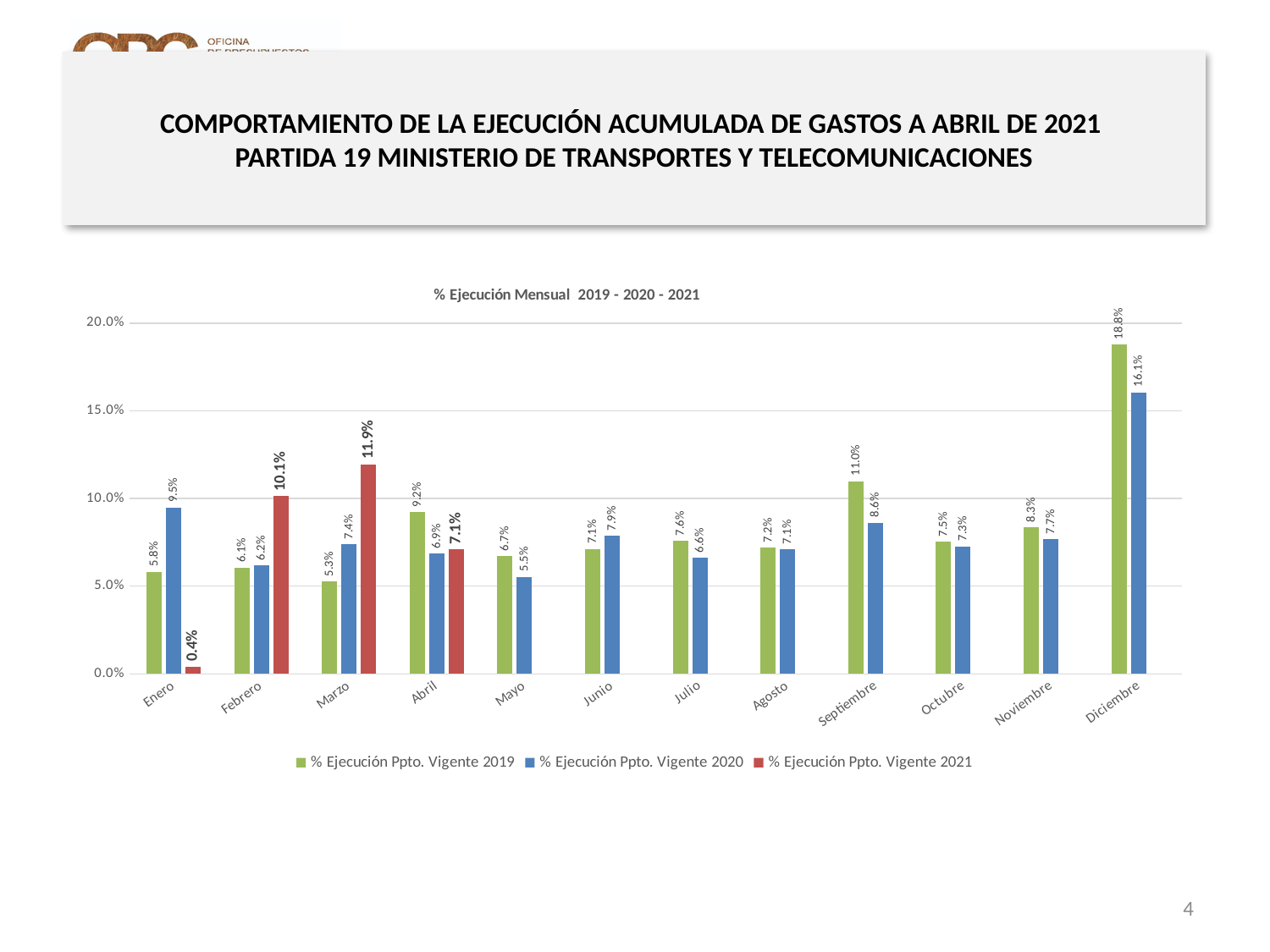
What is the difference between the 2019 and 2020 values in Diciembre? 2.7% How many series does the legend list? 3 Is the value for % Ejecución Ppto. Vigente 2019 in Septiembre greater or less than 10.0%? greater What is the value for % Ejecución Ppto. Vigente 2021 in Enero? 0.4% In which month is the % Ejecución Ppto. Vigente 2020 series highest? Diciembre What is the value for % Ejecución Ppto. Vigente 2021 in Marzo? 11.9% What kind of chart is shown on the slide? Bar chart What is the value for % Ejecución Ppto. Vigente 2019 in Diciembre? 18.8% In which month is the % Ejecución Ppto. Vigente 2019 series lowest? Marzo What is the value for % Ejecución Ppto. Vigente 2020 in Enero? 9.5% How many months are shown on the x axis? 12 Which is larger in Abril: the 2019 value or the 2020 value? 2019 value (9.2%)